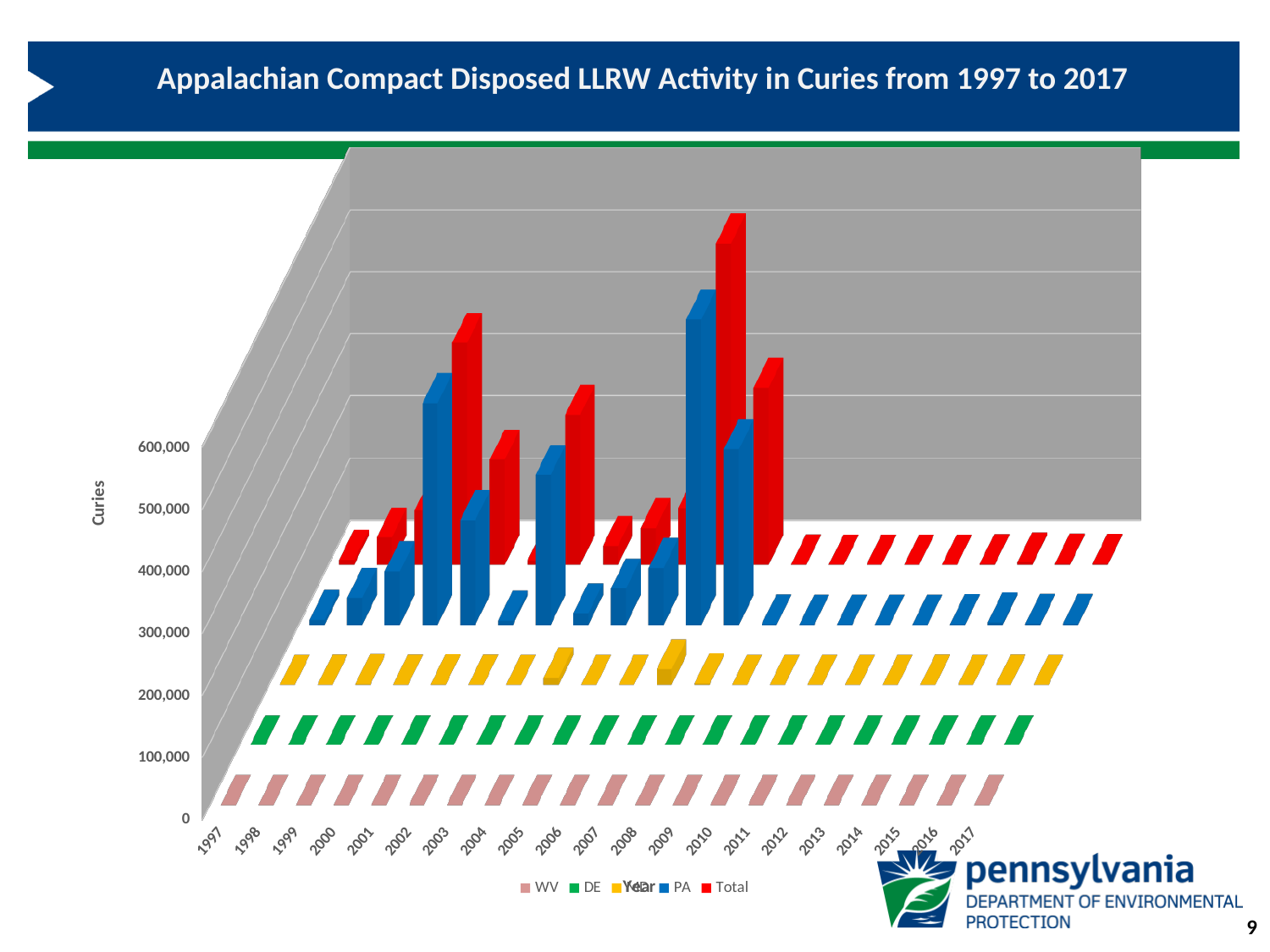
What is the title of the chart? Appalachian Compact Disposed LLRW Activity in Curies from 1997 to 2017 What kind of chart is shown on the slide? bar chart Is the WV value for 2005 greater or less than 100,000? less What colour represents the Total series in the chart? red In which year is the Total series highest? 2007 How many years are shown along the x axis of the chart? 21 Which year has the larger Total value, 2003 or 2006? 2003 Is the Total value for 2010 greater or less than 300,000? less Which year has the larger PA value, 2003 or 2006? 2003 How many series does the chart's legend list? 5 In which year is the PA series highest? 2007